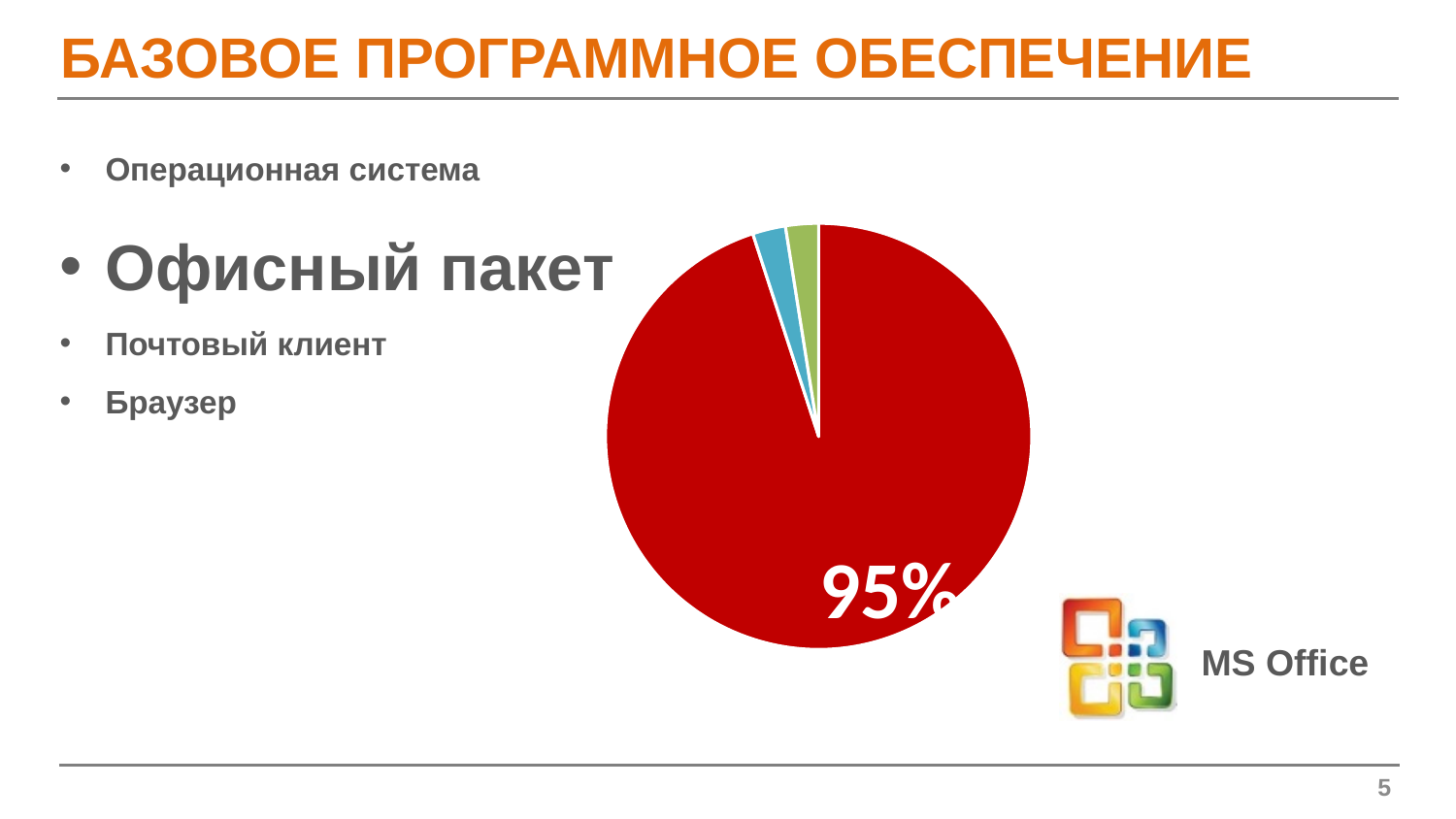
What is the title of the slide containing the pie chart? БАЗОВОЕ ПРОГРАММНОЕ ОБЕСПЕЧЕНИЕ Which is larger in the pie chart, the red slice or the blue slice? the red slice What share of the pie does the red slice represent? 95% What kind of chart is shown on the slide? pie chart What percentage is printed on the largest slice of the pie chart? 95% Which product name is shown next to the pie chart with its logo? MS Office Is the red slice of the pie chart greater or less than 50%? greater What colour is the largest slice of the pie chart? red How many slices does the pie chart have? 3 Which is larger in the pie chart, the red slice or the green slice? the red slice Is the blue slice of the pie chart greater or less than 10%? less